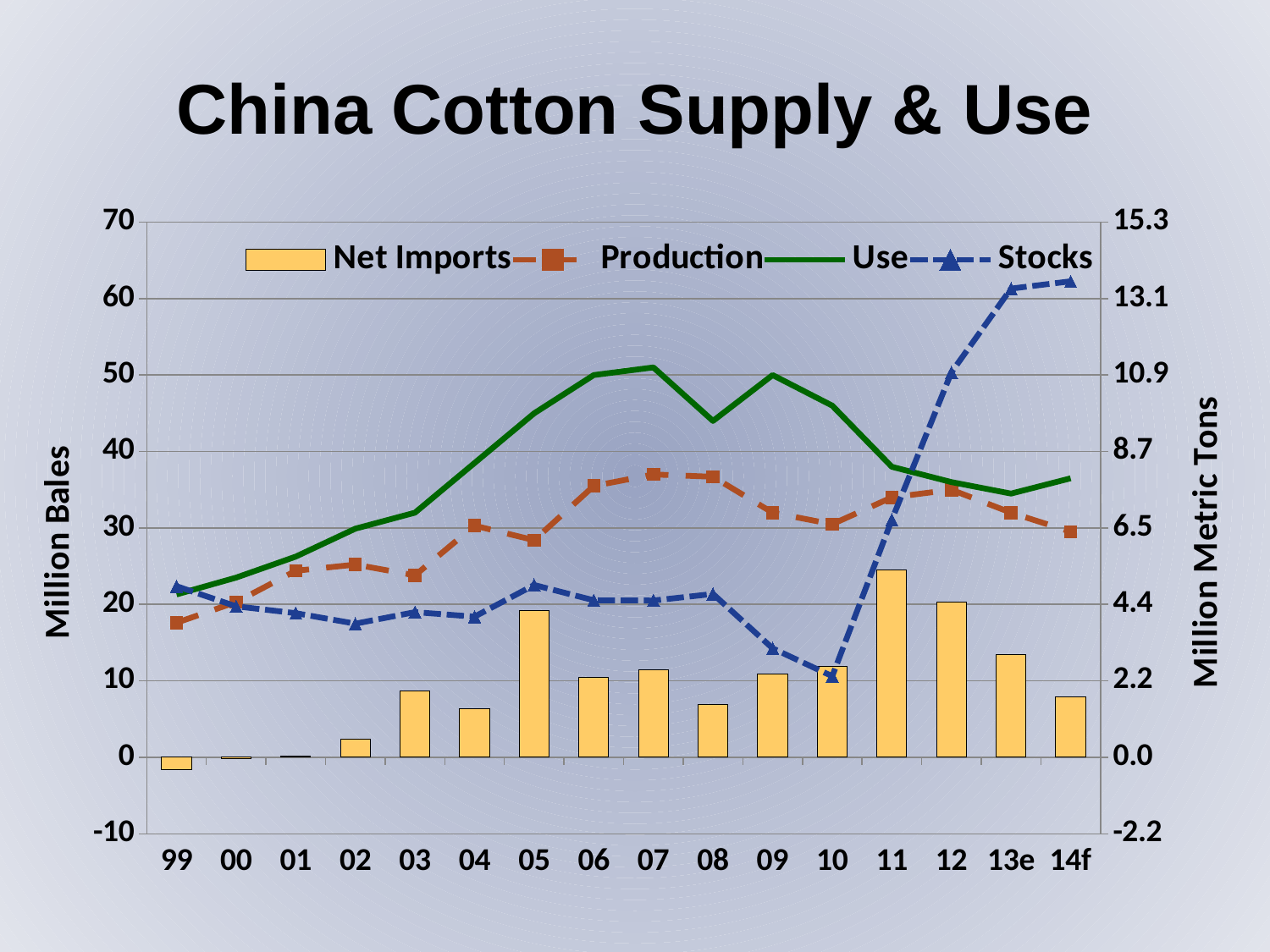
Is the Production value for 99 greater or less than 20? less How many years are shown along the x axis? 16 What kind of chart is shown on the slide? A combination bar and line chart In 07, which is larger, Use or Production? Use In which year are Net Imports highest? 11 How many series does the legend list? 4 In which year is the Use line at its lowest? 99 Is the Stocks value for 12 greater or less than 40 on the left axis? greater In which year is the Stocks line at its lowest? 10 Is the Net Imports value for 11 greater or less than 20? greater What is the label of the right-hand vertical axis? Million Metric Tons Does the Stocks line rise or fall from 10 to 13e? Rise